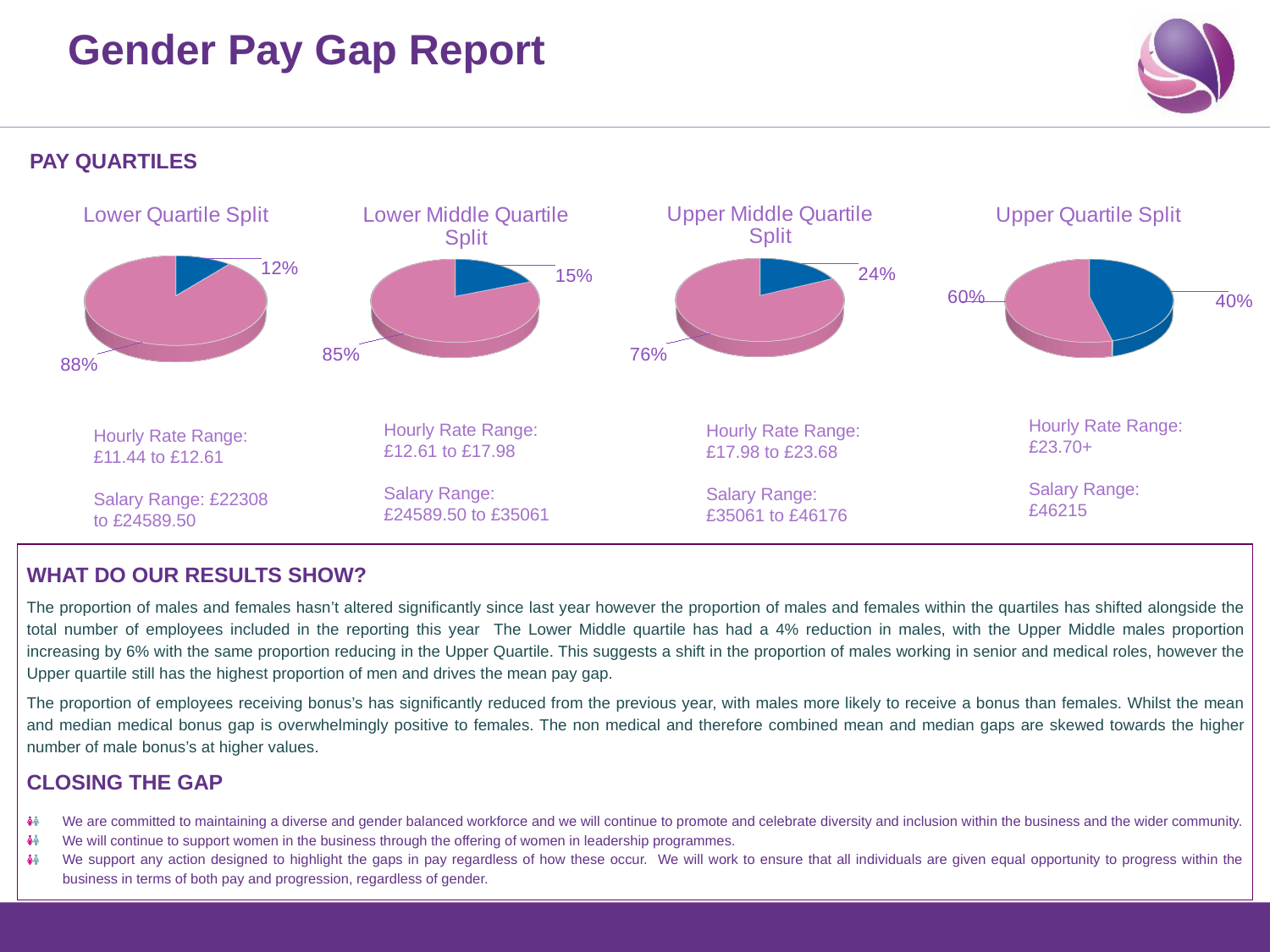
Which of the four pie charts has the largest blue slice? Upper Quartile Split In the Lower Middle Quartile Split chart, what percentage does the blue slice represent? 15% How many slices does the Upper Middle Quartile Split pie chart have? 2 In the Upper Middle Quartile Split chart, what percentage does the pink slice represent? 76% In the Lower Quartile Split chart, what percentage does the pink slice represent? 88% In the Upper Quartile Split chart, what is the difference between the pink slice and the blue slice? 20% In the Lower Quartile Split chart, what percentage does the blue slice represent? 12% Is the blue slice larger in the Upper Middle Quartile Split chart or the Lower Middle Quartile Split chart? Upper Middle Quartile Split How many pie charts are shown in the Pay Quartiles section of the slide? 4 In the Upper Quartile Split chart, what percentage does the blue slice represent? 40% What kind of chart is the Lower Quartile Split chart? pie chart Which of the four pie charts has the smallest blue slice? Lower Quartile Split